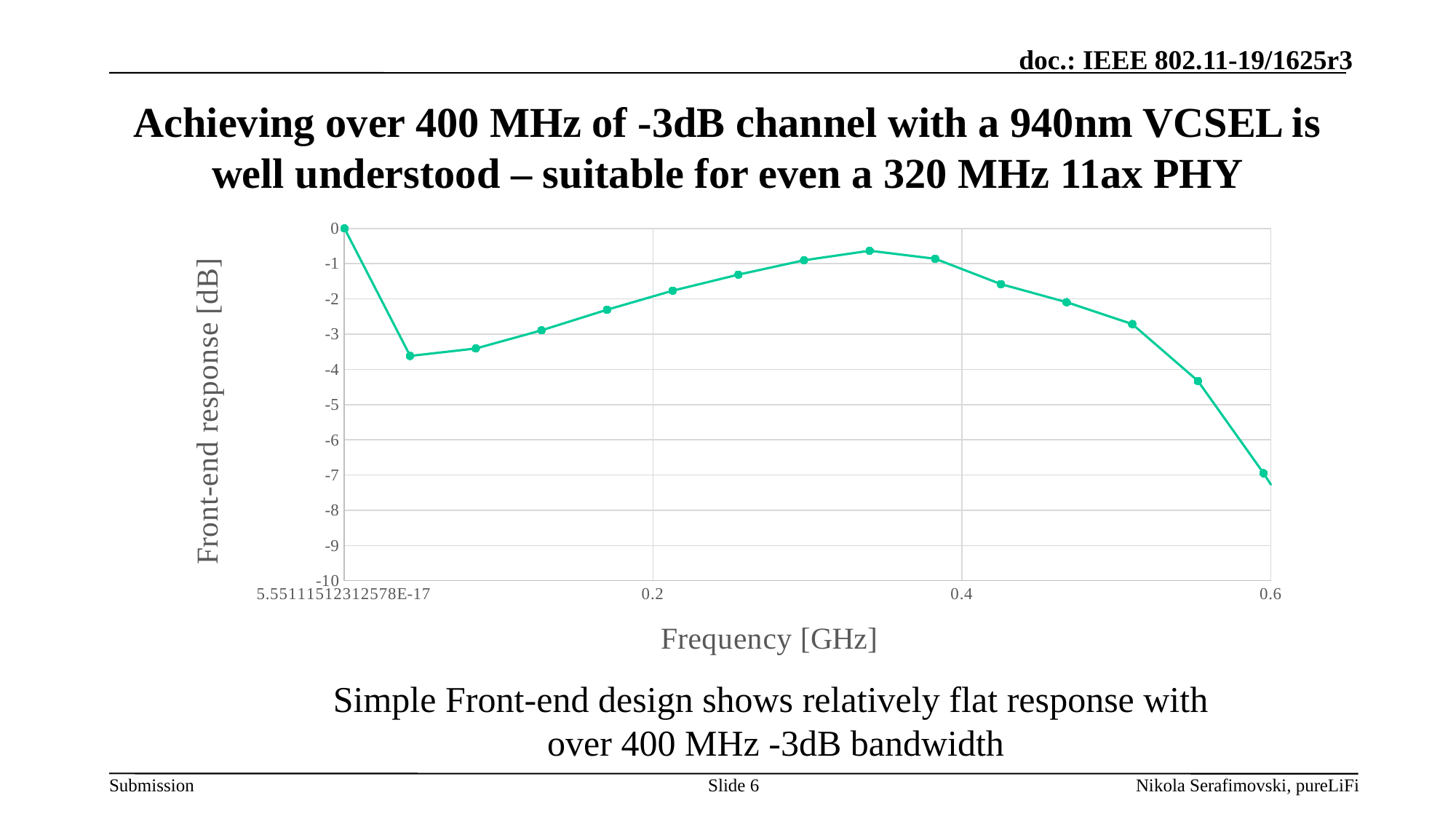
Between 0.4 GHz and 0.6 GHz, does the front-end response rise or fall? fall What kind of chart is shown on the slide? line chart What is the y-axis title of the chart? Front-end response [dB] At which frequency does the front-end response reach its highest value? the first point (lowest frequency, 0 dB) Is the front-end response at the last data point (near 0.6 GHz) greater or less than -5? less Is the front-end response at the data point nearest 0.2 GHz greater or less than -2? greater What is the x-axis title of the chart? Frequency [GHz] Which is larger: the front-end response at the second data point or at the last data point near 0.6 GHz? the second data point What is the front-end response value of the first data point (at the lowest frequency)? 0 How many data points are plotted on the line? 15 Which data point has the lowest front-end response? the last point, near 0.6 GHz Is the front-end response at the second data point greater or less than -3? less